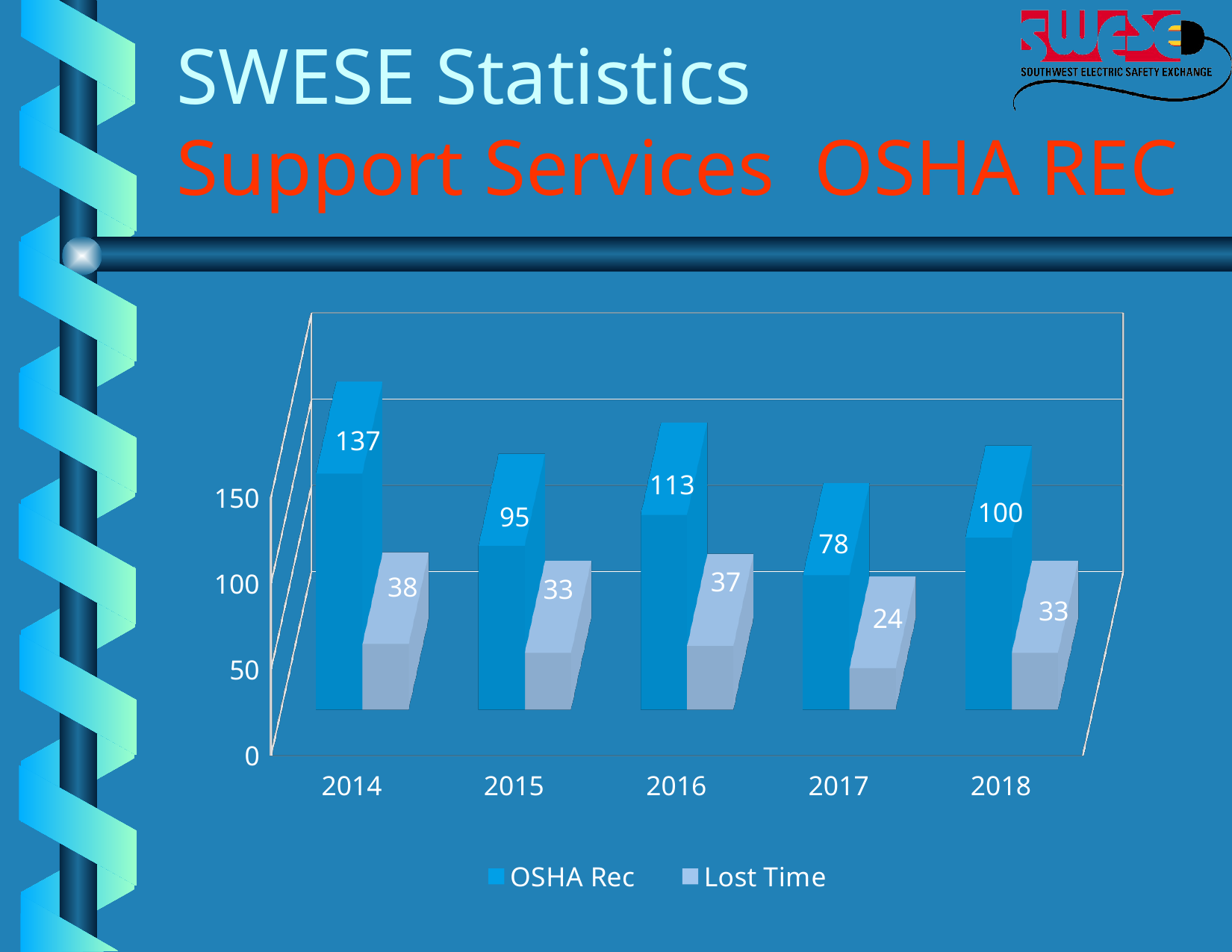
What are the two series listed in the legend? OSHA Rec and Lost Time How many series does the legend list? 2 What is the OSHA Rec value for 2018? 100 What is the Lost Time value for 2017? 24 How many years are shown on the x axis? 5 Which year has the highest OSHA Rec value? 2014 Which year has the lowest Lost Time value? 2017 What is the difference between the OSHA Rec values for 2014 and 2015? 42 Which is larger, the OSHA Rec value for 2016 or for 2018? 2016 What kind of chart is shown on the slide? Bar chart What is the difference between the OSHA Rec and Lost Time values for 2017? 54 What is the OSHA Rec value for 2014? 137